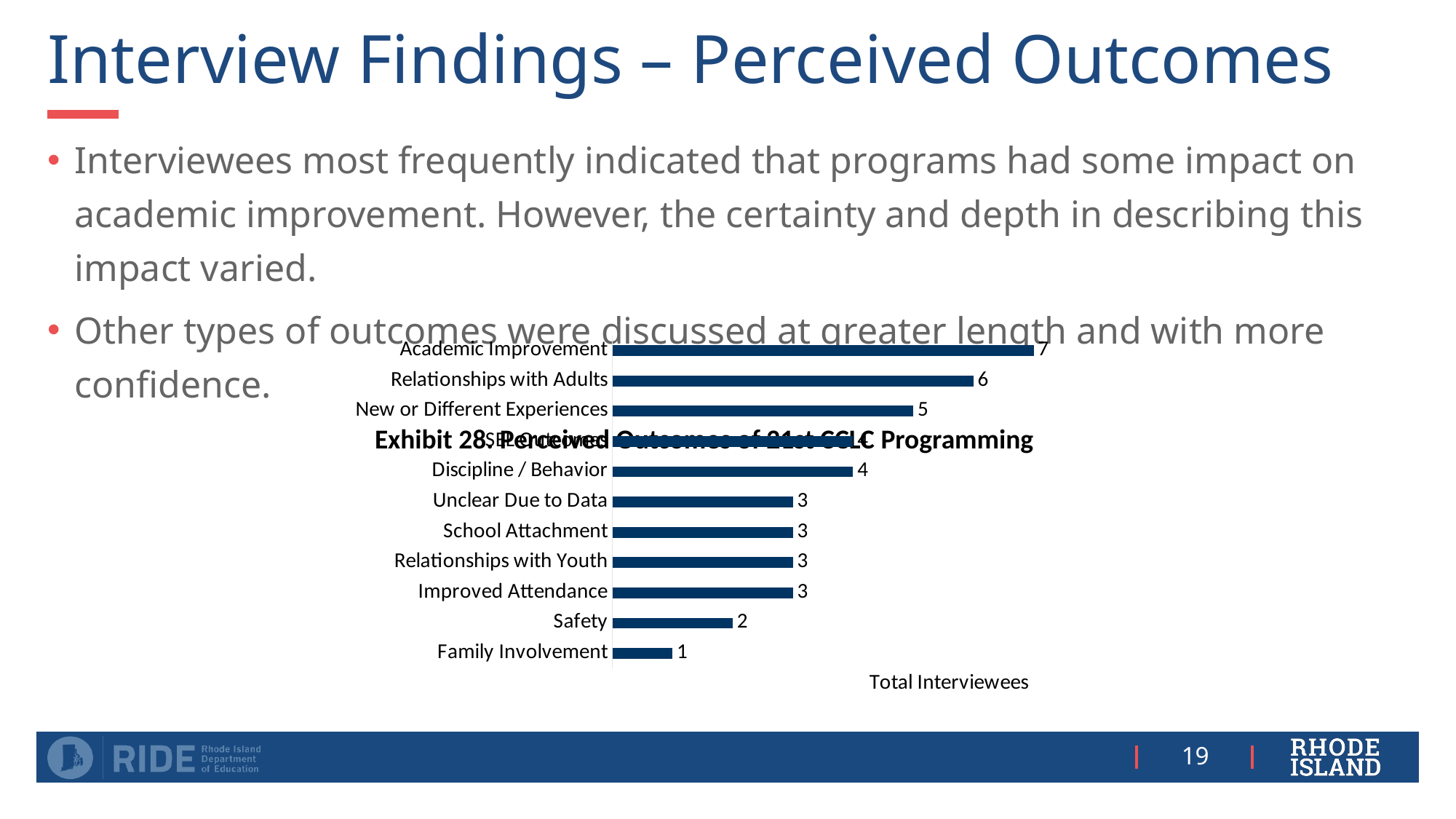
What is the value for New or Different Experiences? 5 Which category has the lowest number of interviewees? Family Involvement How many categories (bars) are plotted in the chart? 11 How many interviewees are shown for Academic Improvement? 7 What is the label of the horizontal axis of the chart? Total Interviewees Which category has the highest number of interviewees? Academic Improvement Which is larger, the value for Relationships with Adults or the value for Improved Attendance? Relationships with Adults What is the difference between the values for Academic Improvement and Discipline / Behavior? 3 What is the value for Family Involvement? 1 What is the value for Relationships with Adults? 6 What is the value for Safety? 2 What kind of chart is shown on the slide? Bar chart